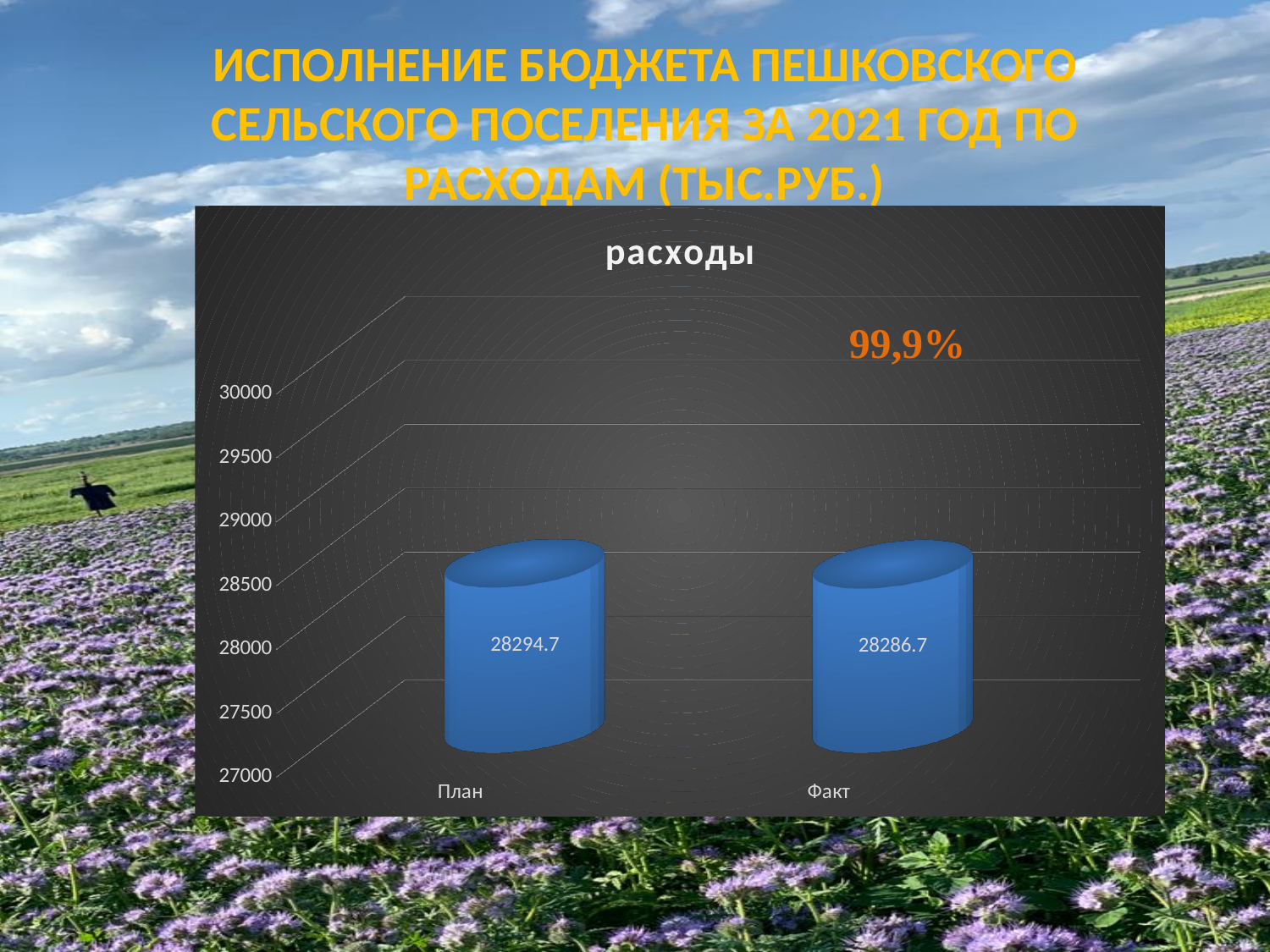
What percentage is printed above the bars in the chart? 99,9% What is the lowest value shown on the y axis? 27000 What is the difference between the План and Факт values? 8.0 Is the value for План greater or less than 28000? greater What is the title of the chart? расходы What is the value for Факт? 28286.7 What kind of chart is shown on the slide? bar chart Which category has the lowest value? Факт What is the value for План? 28294.7 How many categories are shown on the x axis? 2 Which category has the higher value, План or Факт? План Is the value for Факт greater or less than 28500? less